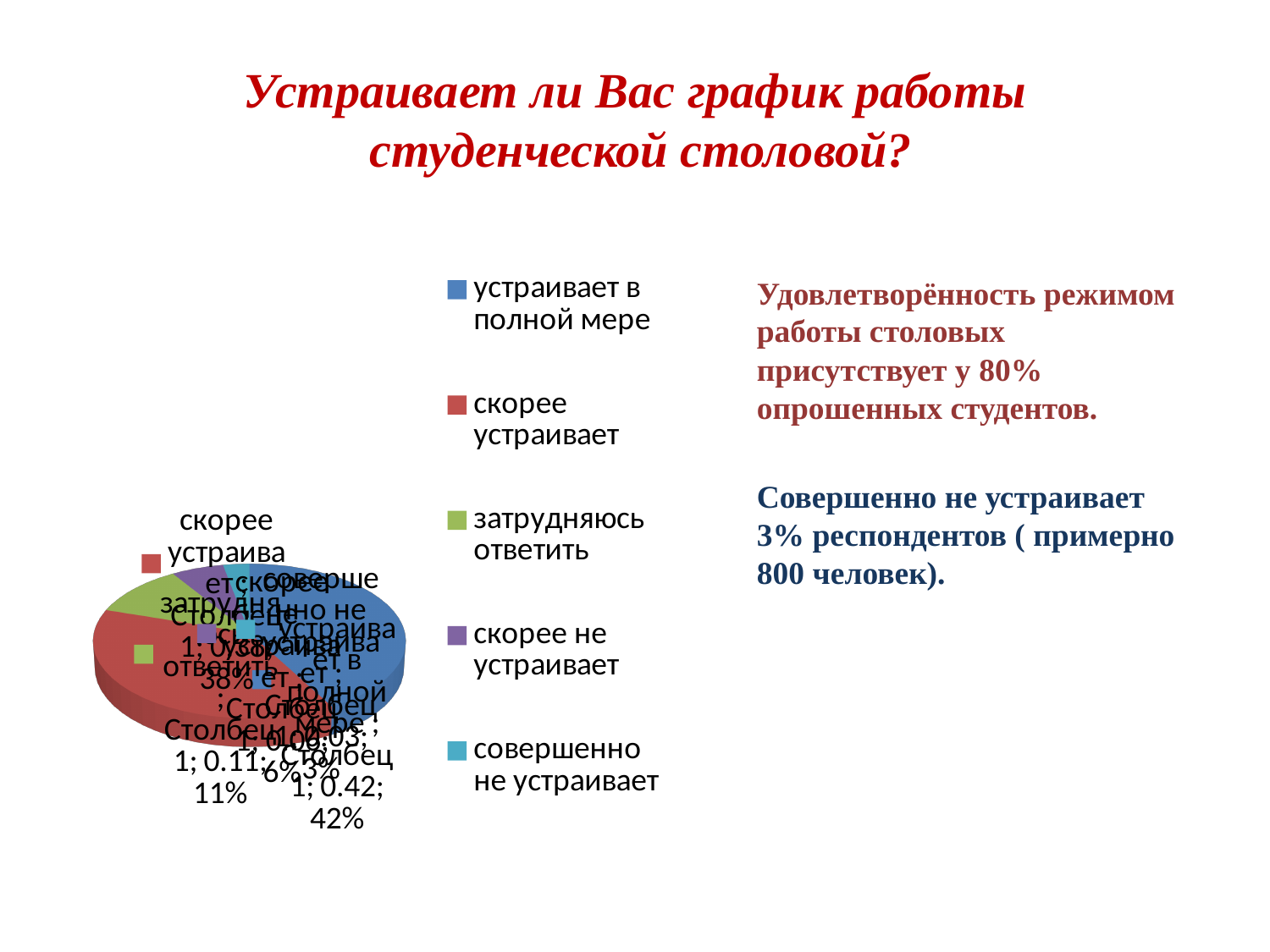
What colour is the slice for "скорее устраивает"? red Which answer has the smallest slice of the pie? совершенно не устраивает How many categories does the legend of the pie chart list? 5 What kind of chart is shown on the slide? pie chart What share of respondents answered "устраивает в полной мере"? 42% What share of respondents answered "совершенно не устраивает"? 3% Which is larger: the share for "устраивает в полной мере" or for "скорее устраивает"? устраивает в полной мере Which legend entry is shown in blue? устраивает в полной мере What share of respondents answered "скорее устраивает"? 38% By how many percentage points does "устраивает в полной мере" exceed "скорее устраивает"? 4 Which answer has the largest slice of the pie? устраивает в полной мере What is the combined share of "устраивает в полной мере" and "скорее устраивает"? 80%